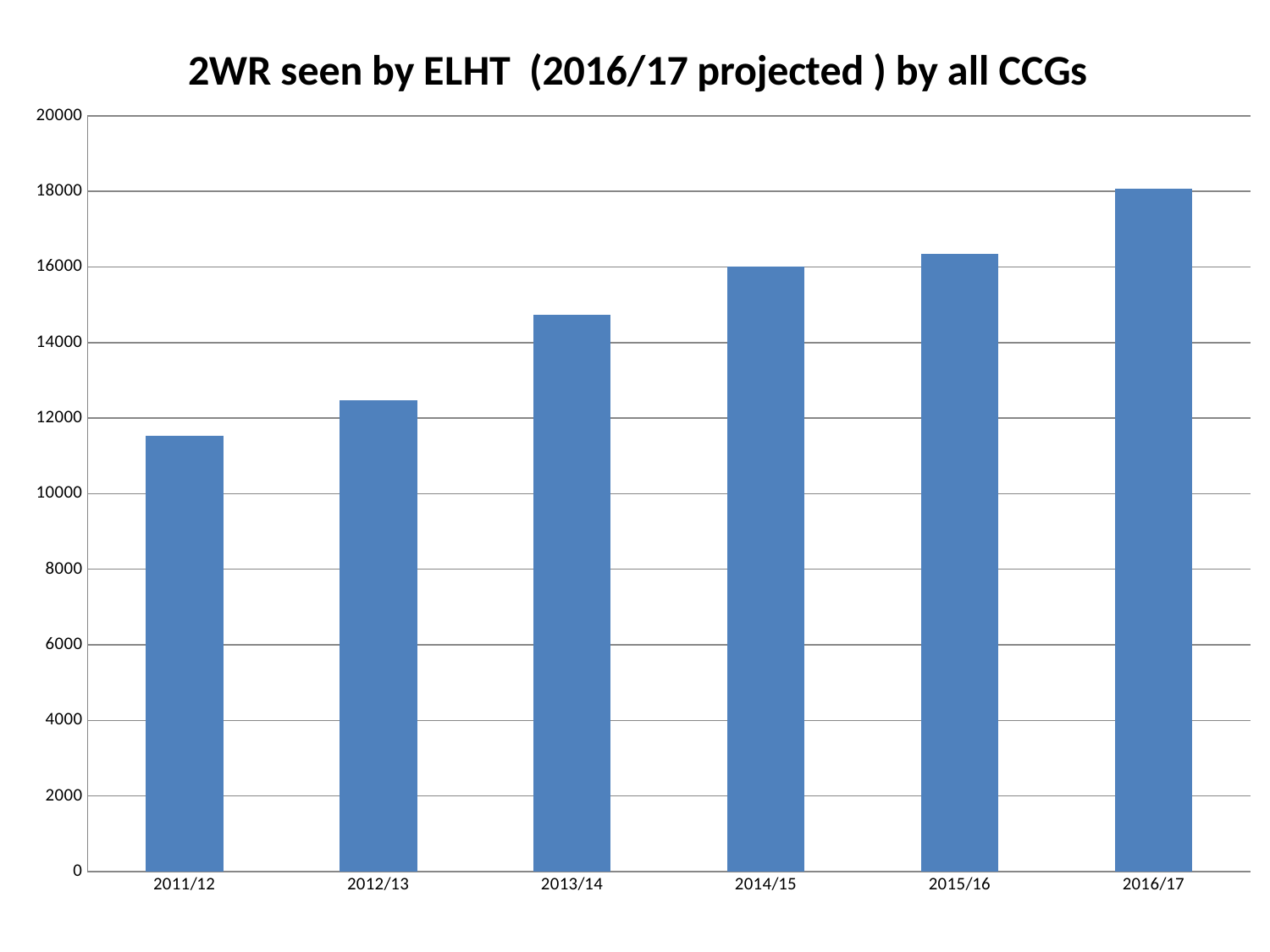
How many years are shown on the x axis of the chart? 6 What is the title of the chart? 2WR seen by ELHT (2016/17 projected ) by all CCGs Is the value for 2013/14 greater or less than 14000? greater Is the value for 2016/17 greater or less than 16000? greater Is the value for 2011/12 greater or less than 10000? greater Which year has the lowest value in the chart? 2011/12 Which year has the highest value in the chart? 2016/17 What kind of chart is shown on the slide? bar chart Do the values rise or fall from 2011/12 to 2016/17? rise Which is larger, the value for 2013/14 or the value for 2012/13? 2013/14